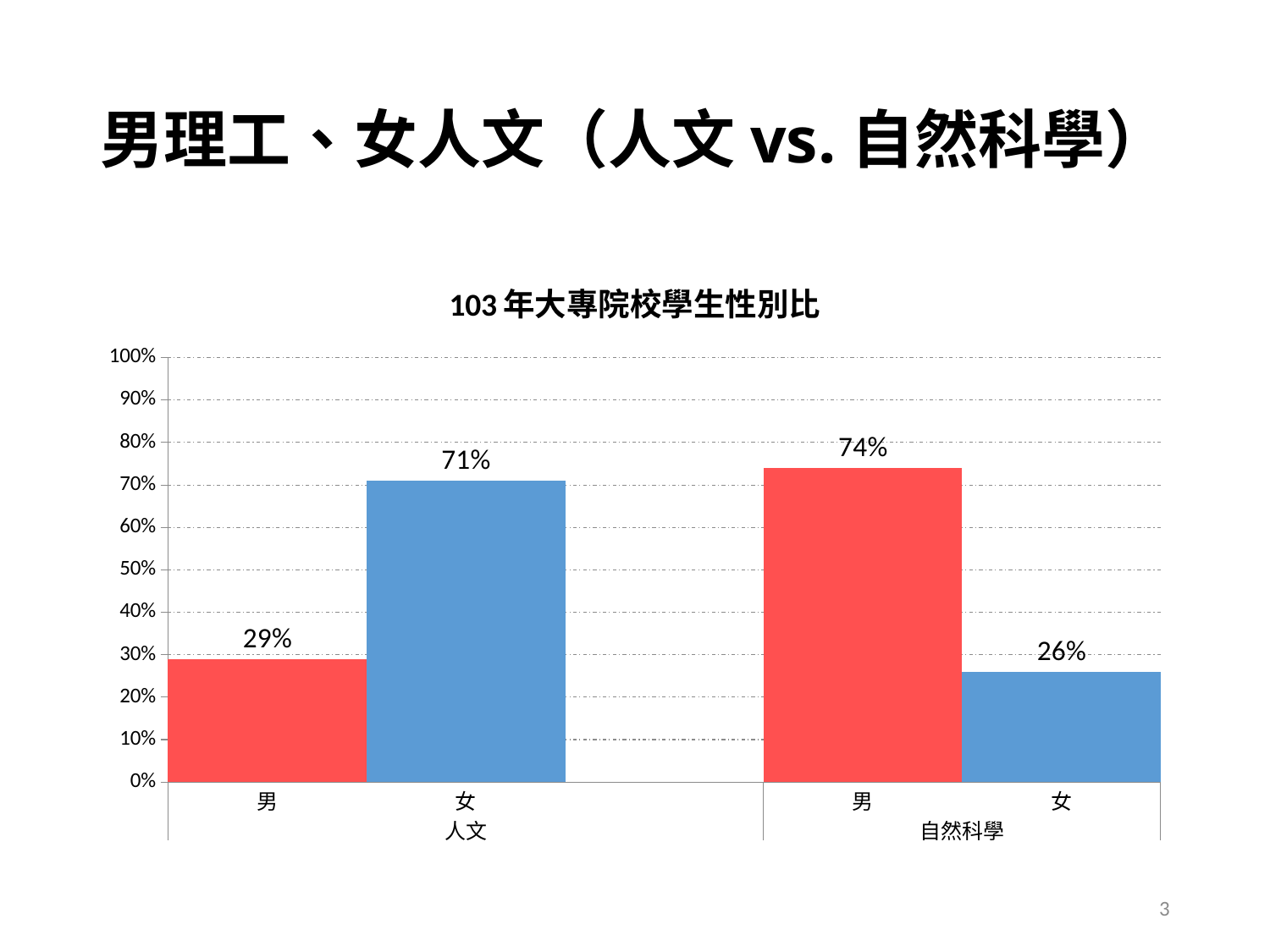
Which bar has the lowest value? 女 in 自然科學 What is the value for 男 in the 自然科學 group? 74% Which bar has the highest value? 男 in 自然科學 What is the title of the chart? 103 年大專院校學生性別比 What is the difference between the 男 values in 自然科學 and 人文? 45% What is the value for 男 in the 人文 group? 29% What is the difference between the 女 and 男 values in the 人文 group? 42% What kind of chart is shown? bar chart What is the value for 女 in the 自然科學 group? 26% How many bars are plotted in the chart? 4 Which is larger: 男 in 人文 or 女 in 自然科學? 男 in 人文 What is the value for 女 in the 人文 group? 71%